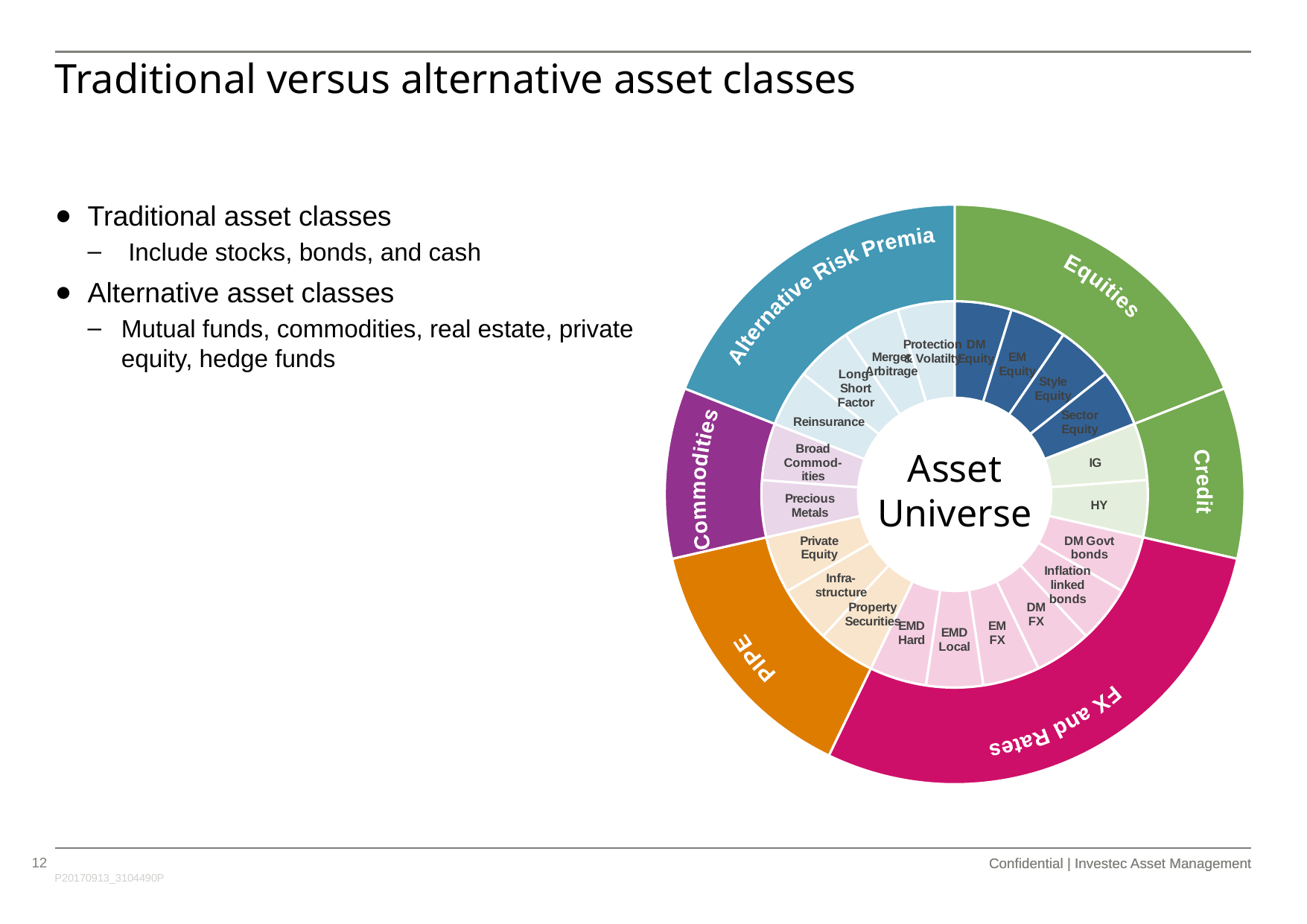
Which two inner-ring segments belong to Commodities? Broad Commodities and Precious Metals Which outer-ring asset class contains the IG and HY segments? Credit How many sub-segments are shown under FX and Rates in the inner ring? 6 Which outer-ring asset class contains the Reinsurance segment? Alternative Risk Premia Which outer-ring asset class contains the Private Equity, Infrastructure and Property Securities segments? PIPE What kind of chart is shown on the slide? Sunburst (multi-level doughnut) chart What colour is the Equities segment in the outer ring? Green How many top-level asset classes are shown in the outer ring of the chart? 6 How many sub-segments are shown under Equities in the inner ring? 4 What text appears in the centre of the chart? Asset Universe Which outer-ring asset class occupies the largest share of the chart? FX and Rates